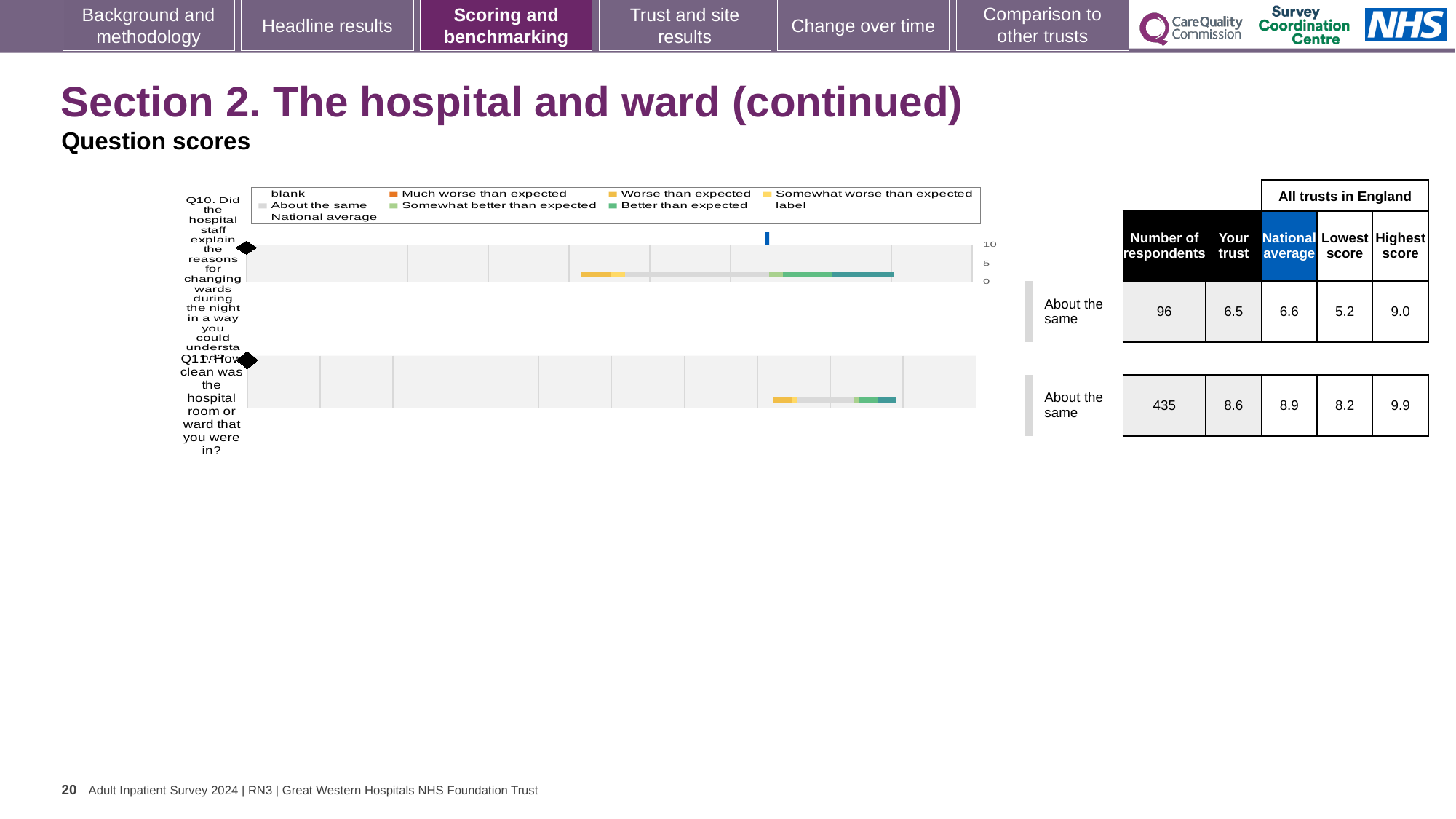
How many survey questions are plotted on the slide? 2 What is the national average score for Q11 (how clean was the hospital room or ward)? 8.9 What is the maximum value shown on the score axis of the Q10 chart? 10 What is the difference between the highest score and the lowest score for Q10? 3.8 What is the 'Your trust' score for Q10? 6.5 What is the highest score across all trusts in England for Q11? 9.9 What is the number of respondents for Q10 (explaining reasons for changing wards during the night)? 96 Which question has the higher 'Your trust' score, Q10 or Q11? Q11 What kind of chart is used to show the question scores for Q10 and Q11? bar chart Which benchmark category is shown for Q10? About the same For Q11, which is larger: the 'Your trust' score or the national average? National average